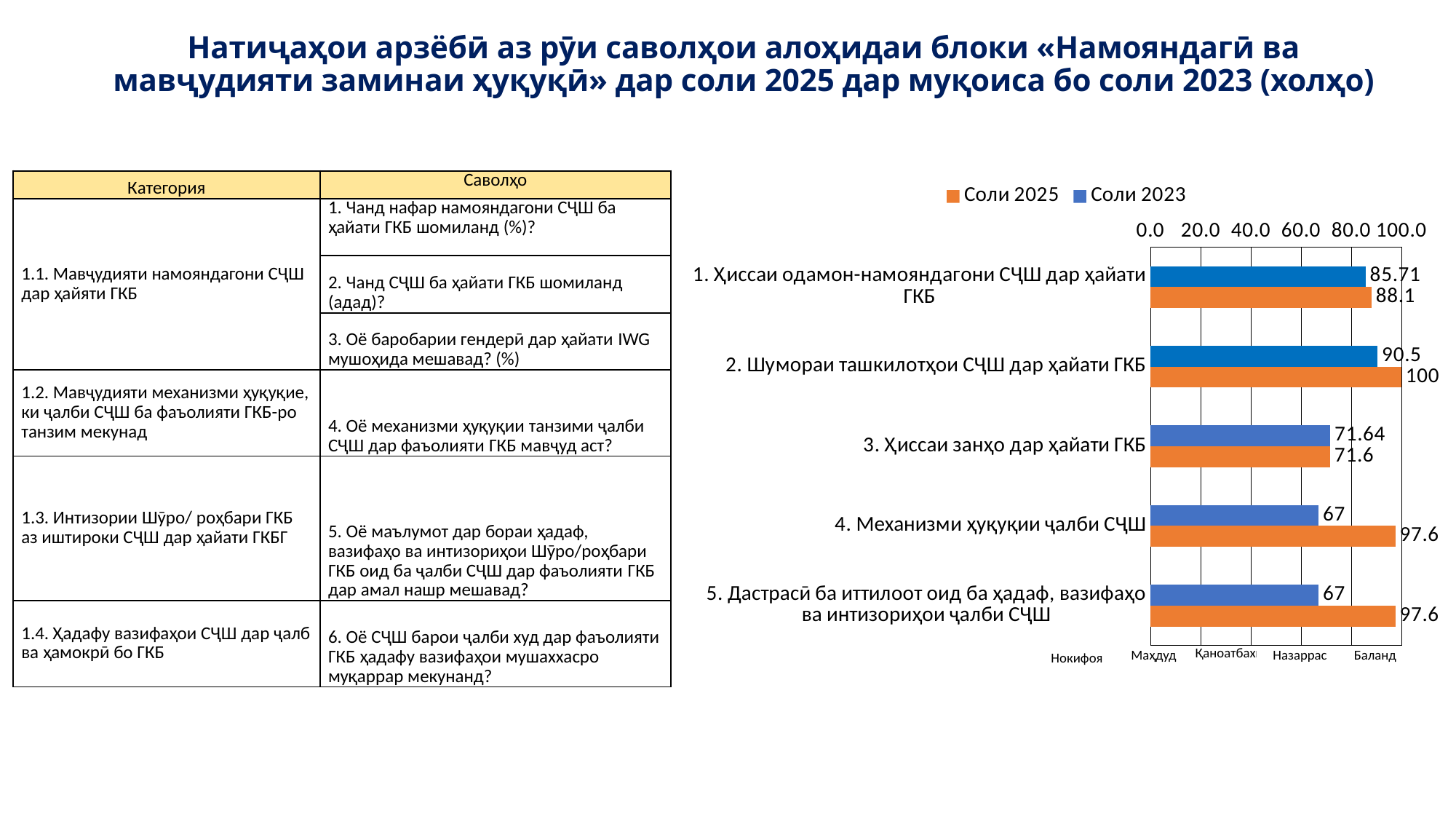
How many series does the chart legend list? 2 Which category has the lowest value for Соли 2025? 3. Ҳиссаи занҳо дар ҳайати ГКБ What is the value for Соли 2023 in the category "3. Ҳиссаи занҳо дар ҳайати ГКБ"? 71.64 What is the difference between the Соли 2025 and Соли 2023 values for "4. Механизми ҳуқуқии ҷалби СҶШ"? 30.6 How many categories are plotted on the chart? 5 What is the value for Соли 2023 in the category "1. Ҳиссаи одамон-намояндагони СҶШ дар ҳайати ГКБ"? 85.71 What is the value for Соли 2025 in the category "4. Механизми ҳуқуқии ҷалби СҶШ"? 97.6 What is the value for Соли 2025 in the category "2. Шумораи ташкилотҳои СҶШ дар ҳайати ГКБ"? 100 Which colour represents the Соли 2023 series in the chart? blue What kind of chart is shown on the slide? bar chart For "2. Шумораи ташкилотҳои СҶШ дар ҳайати ГКБ", which series has the larger value, Соли 2025 or Соли 2023? Соли 2025 Which category has the highest value for Соли 2025? 2. Шумораи ташкилотҳои СҶШ дар ҳайати ГКБ